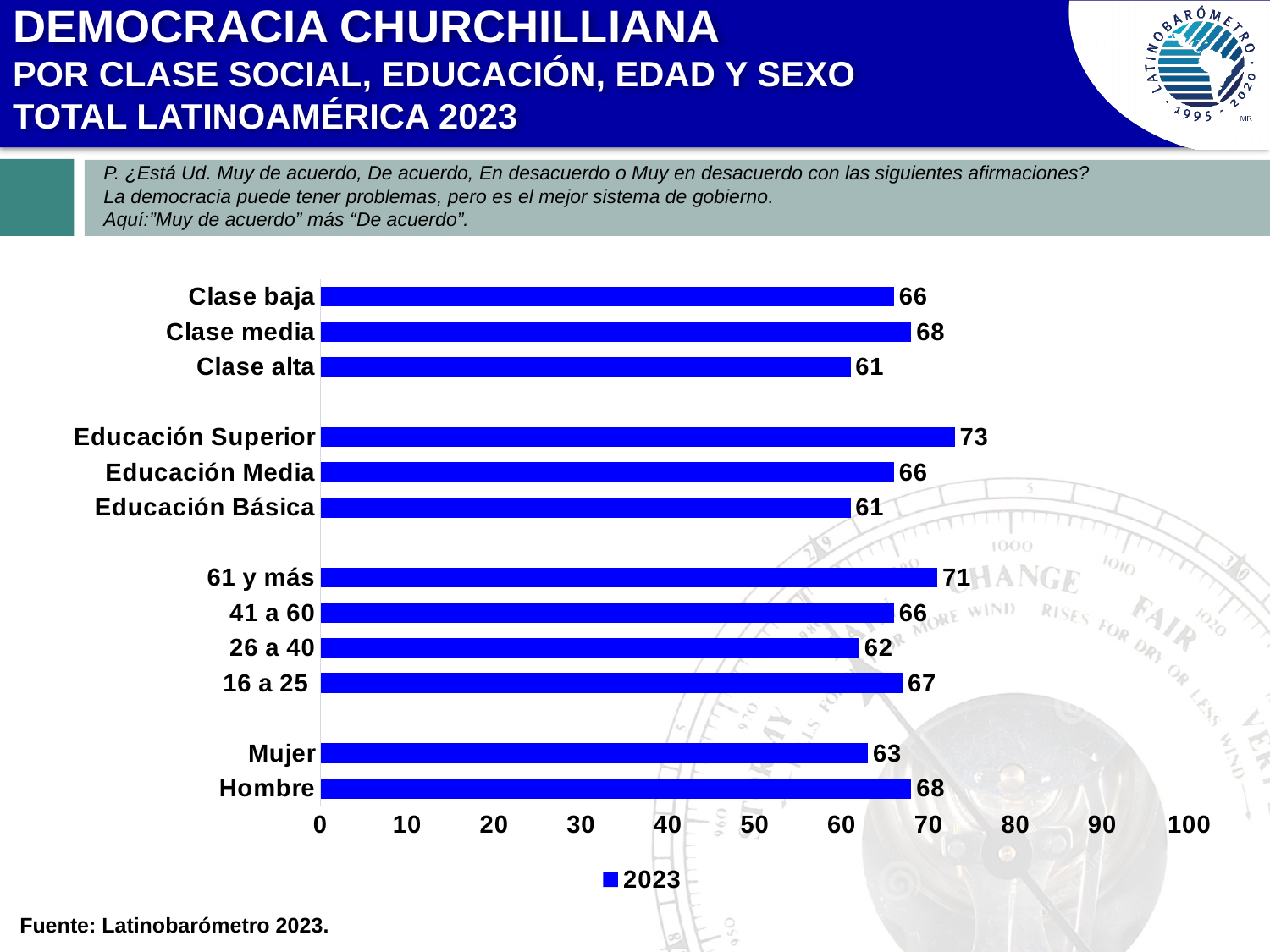
What is the value for Mujer? 63 How many categories are plotted in the chart? 12 What is the difference between the values for Hombre and Mujer? 5 What kind of chart is shown on the slide? Bar chart Is the value for Clase media greater or less than 60? greater What is the value for 26 a 40? 62 How many series does the legend list? 1 Which is larger, the value for 61 y más or the value for 16 a 25? 61 y más Which category has the highest value? Educación Superior What is the difference between the values for Educación Superior and Educación Básica? 12 What is the value for Educación Superior? 73 Which of the three social class categories (Clase baja, Clase media, Clase alta) has the lowest value? Clase alta